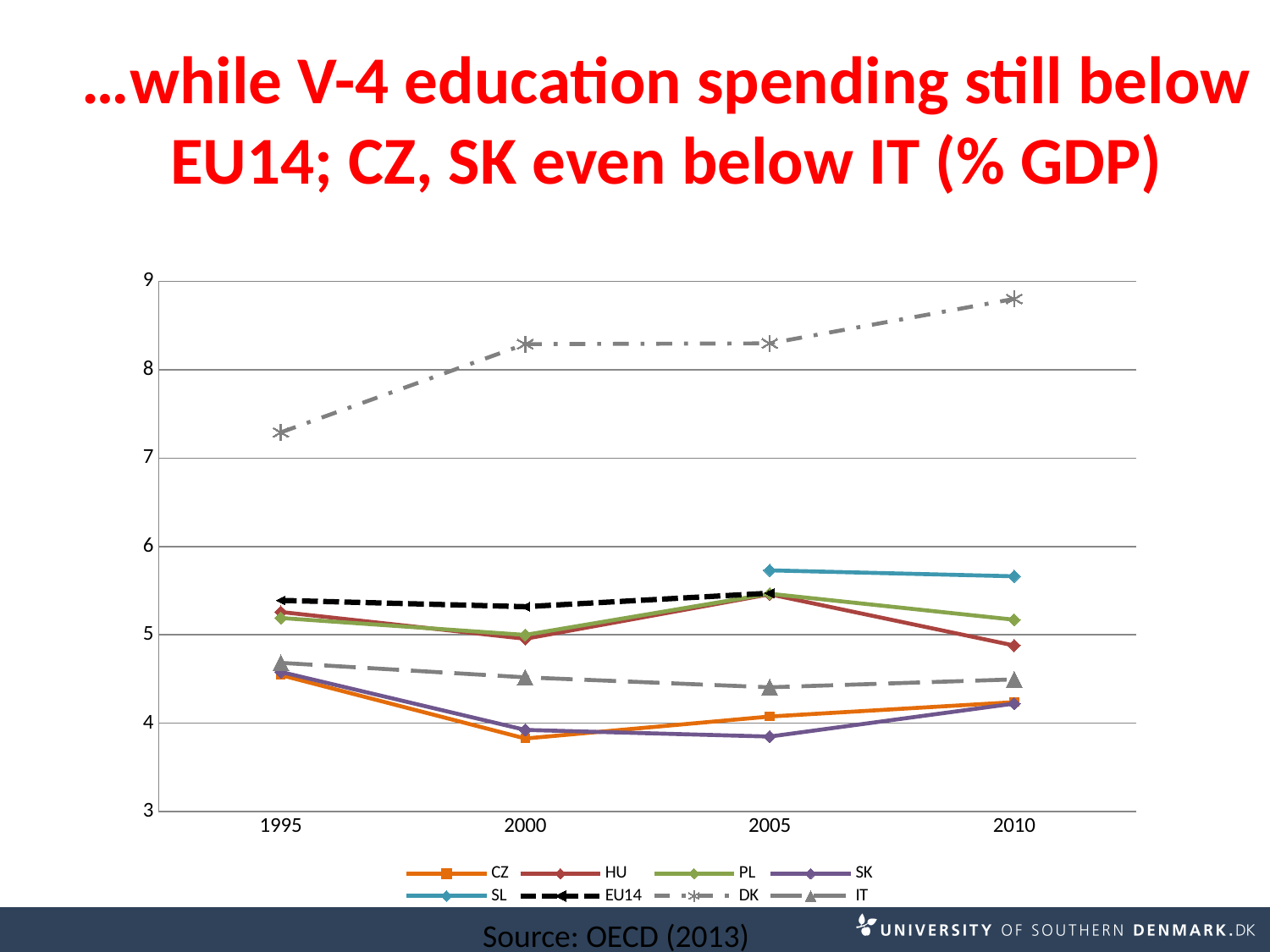
Which series is drawn with a thick dashed black line? EU14 Is the value for SL in 2005 greater or less than 6? less How many series does the legend list? 8 Is the value for DK in 1995 greater or less than 7? greater Which series has the highest value in 2010? DK In 2000, which is larger, IT or SK? IT Is the value for CZ in 2000 greater or less than 4? less Does the DK series rise or fall from 1995 to 2010? rise How many years are shown on the x axis? 4 Which series has the lowest value in 2005? SK What kind of chart is shown on the slide? line chart